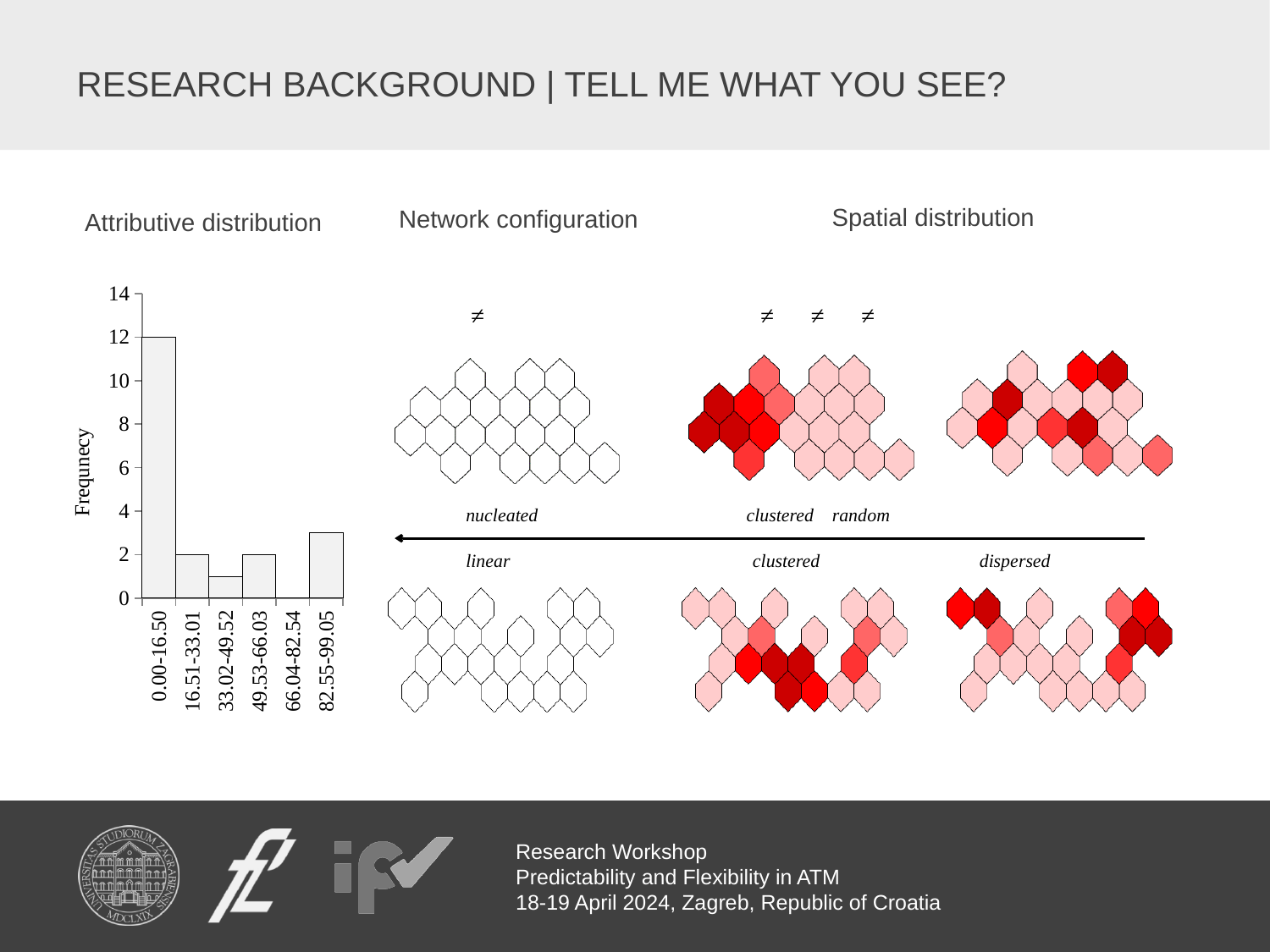
In the Attributive distribution chart, is the value for 82.55-99.05 greater or less than 2? greater In the Attributive distribution chart, which category has the lowest frequency? 66.04-82.54 What is the label on the y axis of the Attributive distribution chart? Frequnecy In the Attributive distribution chart, what is the frequency for the 16.51-33.01 category? 2 In the Attributive distribution chart, what is the frequency for the 0.00-16.50 category? 12 What kind of chart is shown under the heading "Attributive distribution"? bar chart In the Attributive distribution chart, what is the frequency for the 66.04-82.54 category? 0 How many categories are shown on the x axis of the Attributive distribution chart? 6 In the Attributive distribution chart, which category has the highest frequency? 0.00-16.50 In the Attributive distribution chart, is the value for 33.02-49.52 greater or less than 2? less In the Attributive distribution chart, which has the larger frequency: 0.00-16.50 or 82.55-99.05? 0.00-16.50 In the Attributive distribution chart, what is the difference between the frequencies of 0.00-16.50 and 16.51-33.01? 10